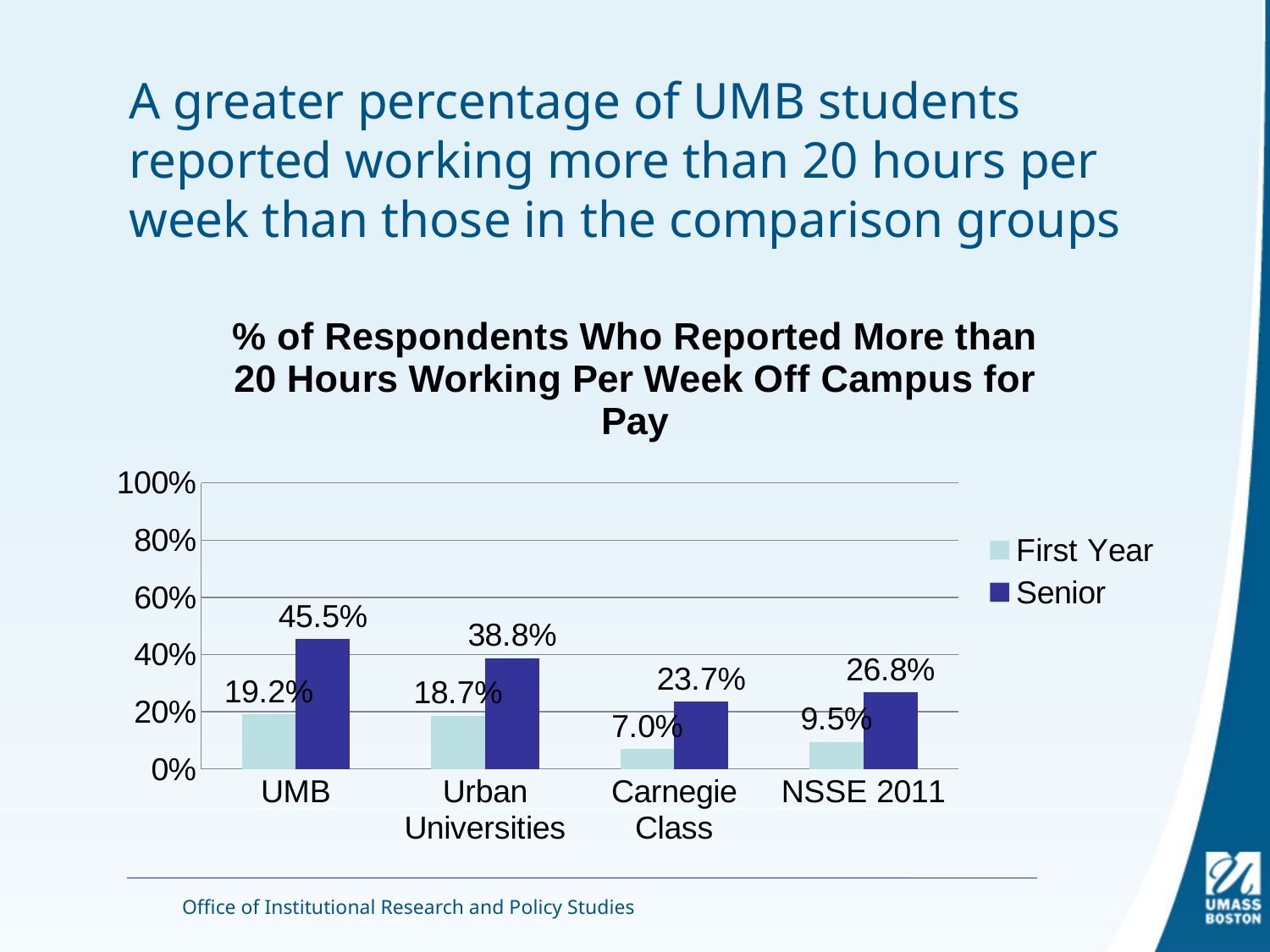
What is the Senior value for NSSE 2011? 26.8% What is the difference between the Senior and First Year values for UMB? 26.3% What is the Senior value for UMB? 45.5% Which category has the lowest First Year value? Carnegie Class What is the First Year value for Carnegie Class? 7.0% What kind of chart is shown? bar chart How many categories are shown on the x axis? 4 Which category has the highest Senior value? UMB Is the Senior value for Urban Universities greater or less than 40%? less What are the two series named in the legend? First Year and Senior How many series does the legend list? 2 Which is larger, the First Year value for Urban Universities or the First Year value for NSSE 2011? Urban Universities